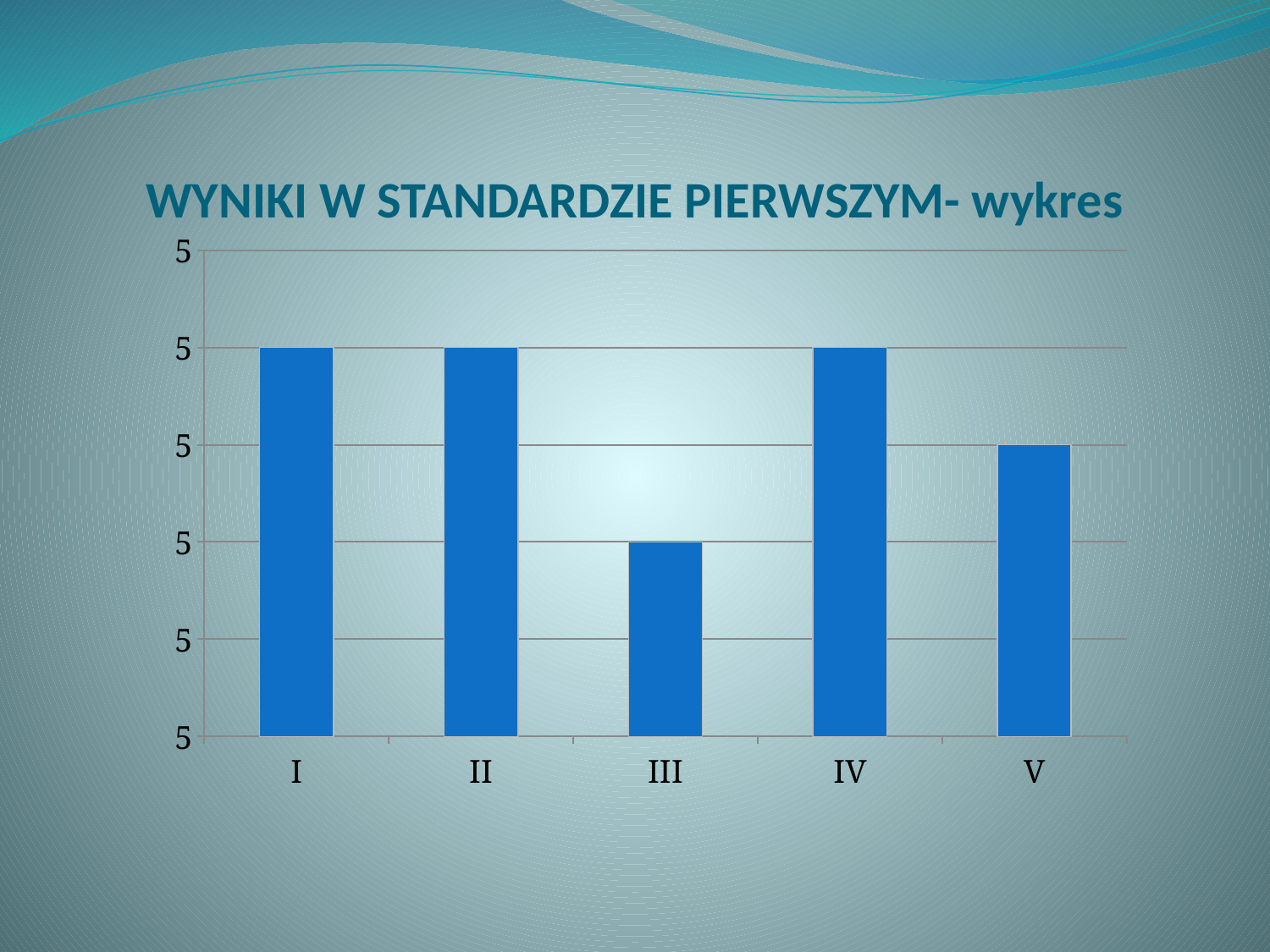
Which is larger, the value for I or the value for III? I Do the values rise or fall from category III to category IV? rise Which is larger, the value for II or the value for V? II What kind of chart is shown on the slide? bar chart Do the values rise or fall from category IV to category V? fall Which category has the lowest bar in the chart? III Which is larger, the value for V or the value for III? V What colour are the bars in the chart? blue How many categories are shown on the x axis of the chart? 5 What is the title of the chart on the slide? WYNIKI W STANDARDZIE PIERWSZYM- wykres